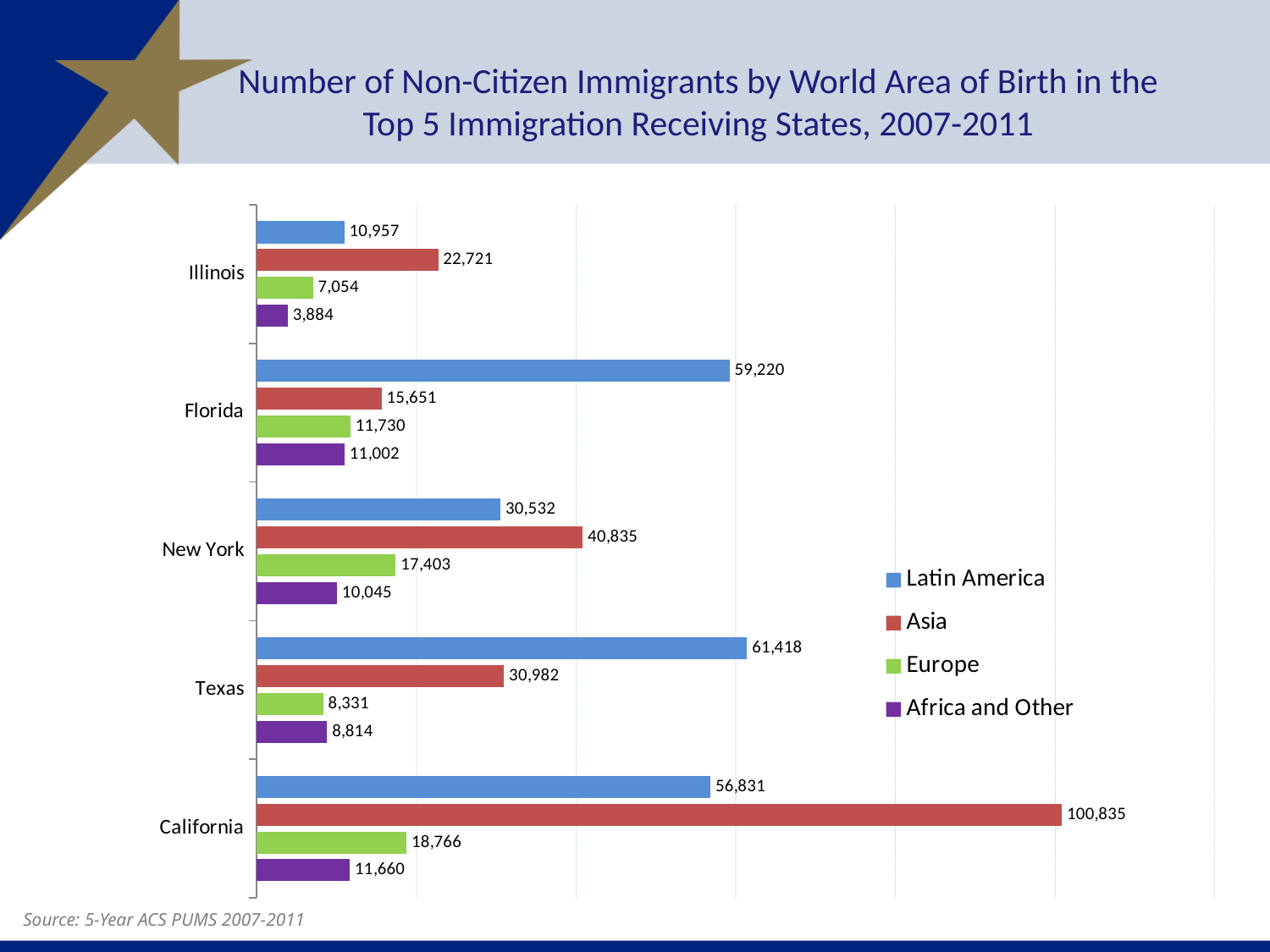
What is the difference between the Asia and Latin America values for California? 44,004 Which state has the lowest value for Africa and Other? Illinois What is the value for Europe in New York? 17,403 What is the value for Africa and Other in Illinois? 3,884 How many series does the legend list? 4 Which state has the highest value for Latin America? Texas What is the source cited below the chart? 5-Year ACS PUMS 2007-2011 What is the value for Latin America in Florida? 59,220 In New York, which is larger: the value for Asia or the value for Latin America? Asia How many states are shown on the chart? 5 What type of chart is shown on the slide? Bar chart What is the number of non-citizen immigrants from Asia in California? 100,835